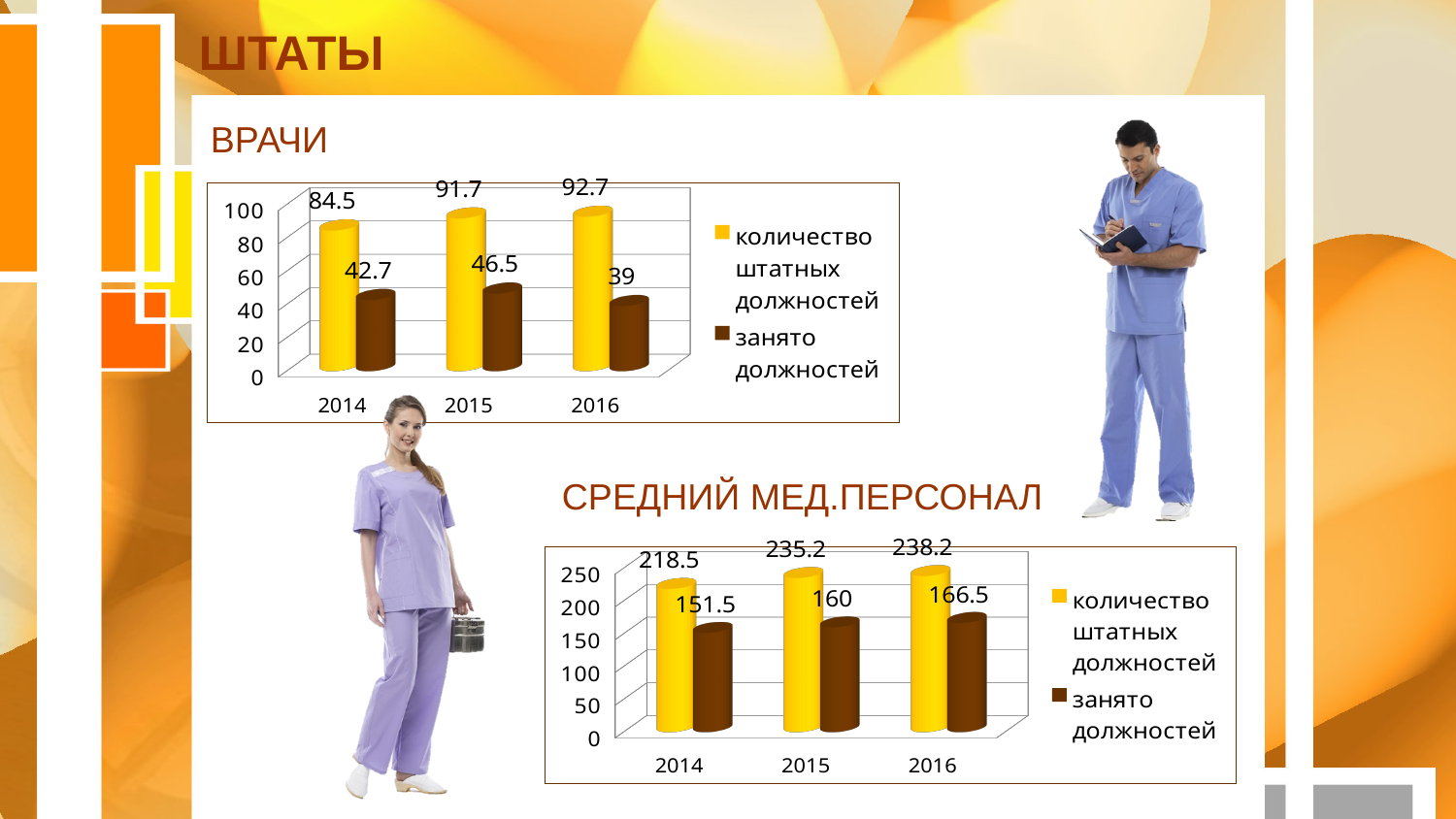
In the СРЕДНИЙ МЕД.ПЕРСОНАЛ chart, how many years are shown on the x axis? 3 In the ВРАЧИ chart, how many series does the legend list? 2 In the СРЕДНИЙ МЕД.ПЕРСОНАЛ chart, which year has the lowest value of занято должностей? 2014 In the СРЕДНИЙ МЕД.ПЕРСОНАЛ chart, what is the value of занято должностей for 2015? 160 In the ВРАЧИ chart, what is the value of количество штатных должностей for 2015? 91.7 What type of chart is the СРЕДНИЙ МЕД.ПЕРСОНАЛ chart? bar chart In the СРЕДНИЙ МЕД.ПЕРСОНАЛ chart, what is the difference between количество штатных должностей in 2015 and 2014? 16.7 In the СРЕДНИЙ МЕД.ПЕРСОНАЛ chart, what is the value of количество штатных должностей for 2016? 238.2 In the ВРАЧИ chart, which year has the highest value of занято должностей? 2015 In the ВРАЧИ chart, what is the difference between количество штатных должностей and занято должностей in 2014? 41.8 In the ВРАЧИ chart, does количество штатных должностей rise or fall from 2014 to 2016? rise In the ВРАЧИ chart, what is the value of занято должностей for 2016? 39